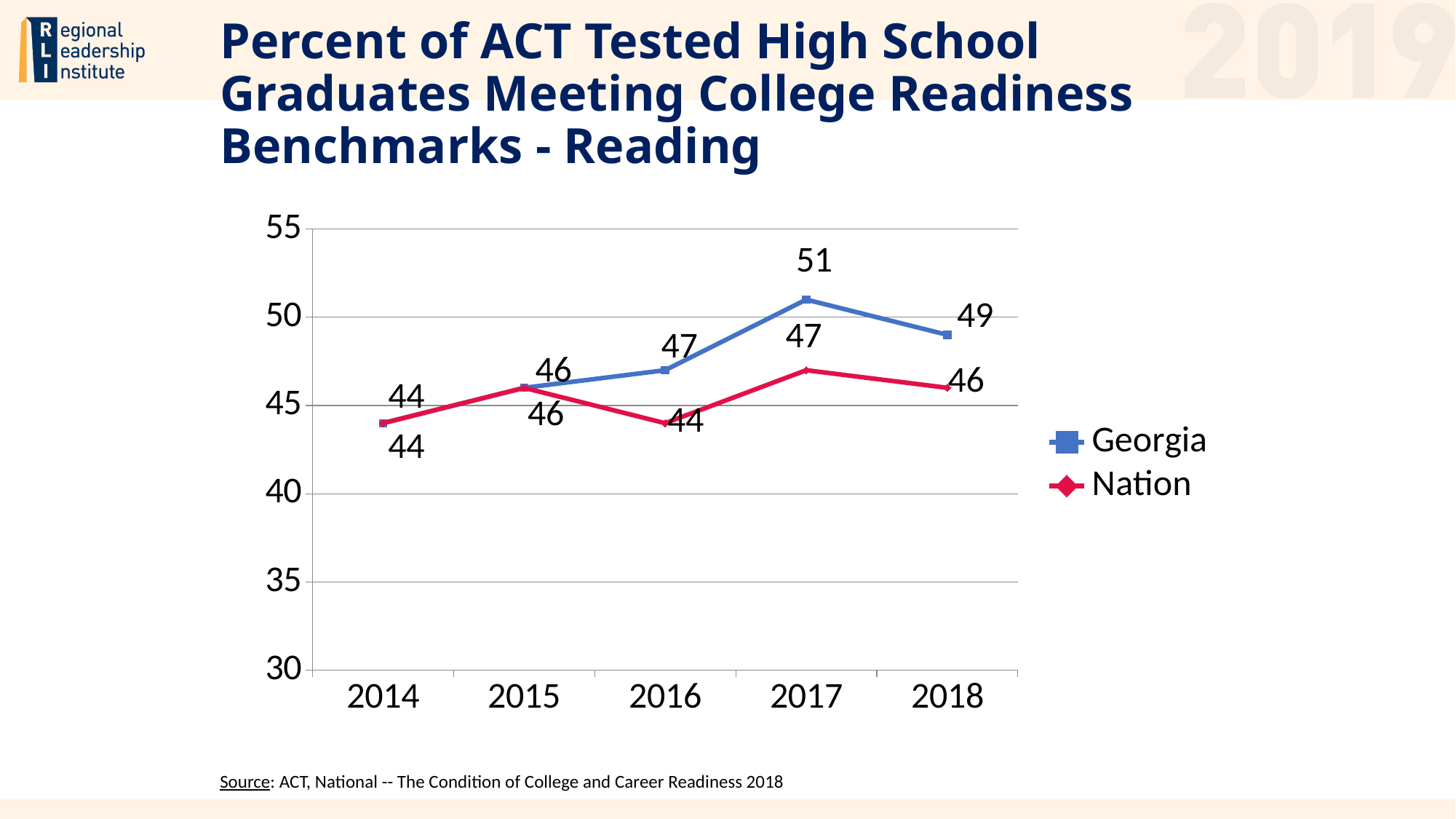
What type of chart is shown on the slide? line chart What was Georgia's value in 2018? 49 What is the difference between Georgia and the Nation in 2017? 4 Did Georgia's value rise or fall from 2017 to 2018? fall In which year did Georgia reach its highest value? 2017 What was the Nation's value in 2016? 44 Which was higher in 2016, Georgia or the Nation? Georgia Which series is shown in red? Nation How many series does the legend list? 2 How many years are shown on the x axis? 5 In which year did Georgia have its lowest value? 2014 What was Georgia's value in 2017? 51